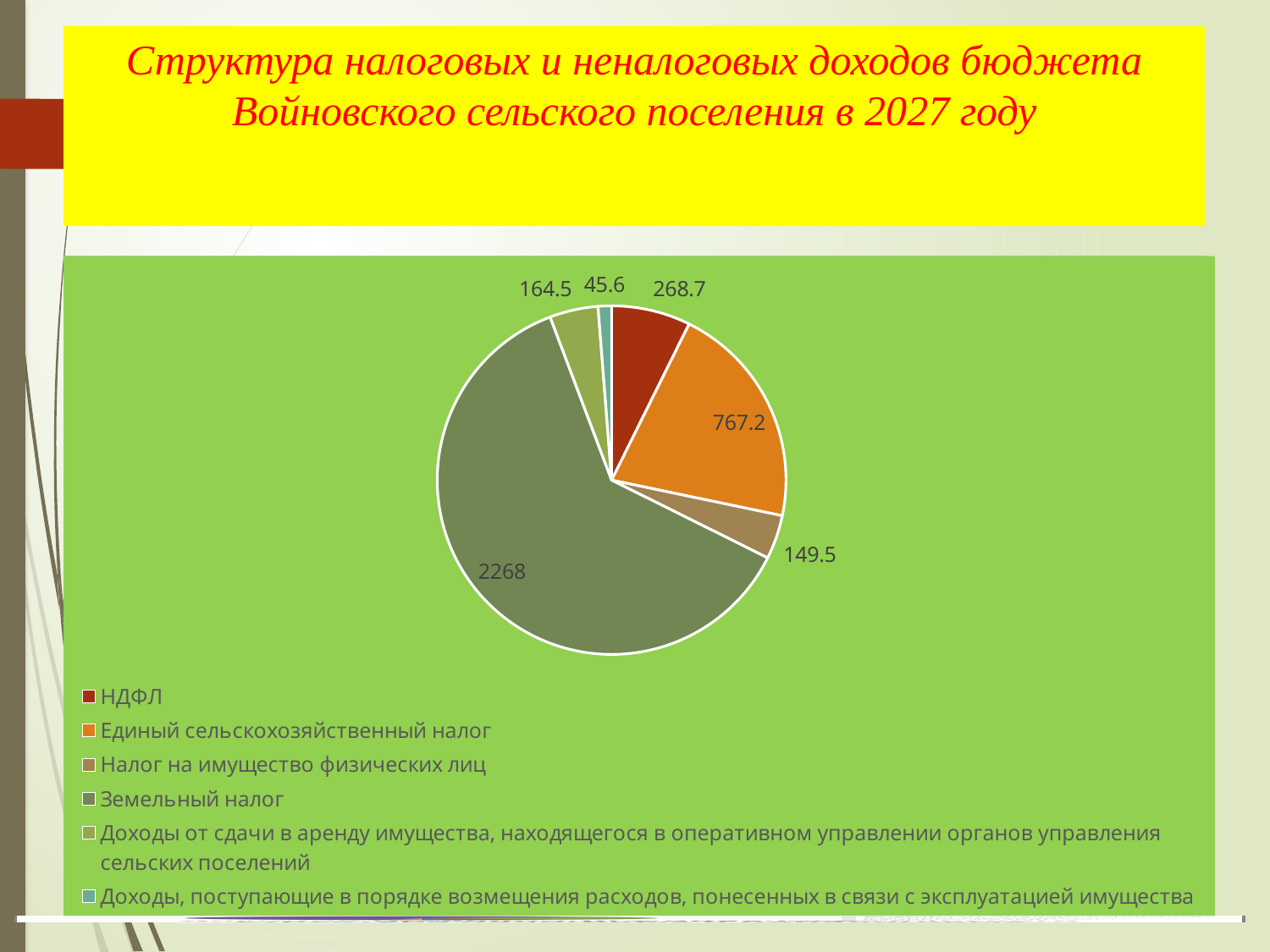
What is the value for Единый сельскохозяйственный налог? 767.2 What type of chart is shown on the slide? Pie chart What is the difference between the values for Земельный налог and Единый сельскохозяйственный налог? 1500.8 What is the value for Налог на имущество физических лиц? 149.5 What is the value for Доходы, поступающие в порядке возмещения расходов, понесенных в связи с эксплуатацией имущества? 45.6 How many categories does the pie chart have? 6 Which category has the smallest slice of the pie? Доходы, поступающие в порядке возмещения расходов, понесенных в связи с эксплуатацией имущества Which category has the largest slice of the pie? Земельный налог Which is larger: the value for НДФЛ or the value for Налог на имущество физических лиц? НДФЛ What is the value for Земельный налог? 2268 What is the title of the slide containing the chart? Структура налоговых и неналоговых доходов бюджета Войновского сельского поселения в 2027 году What is the value for НДФЛ? 268.7